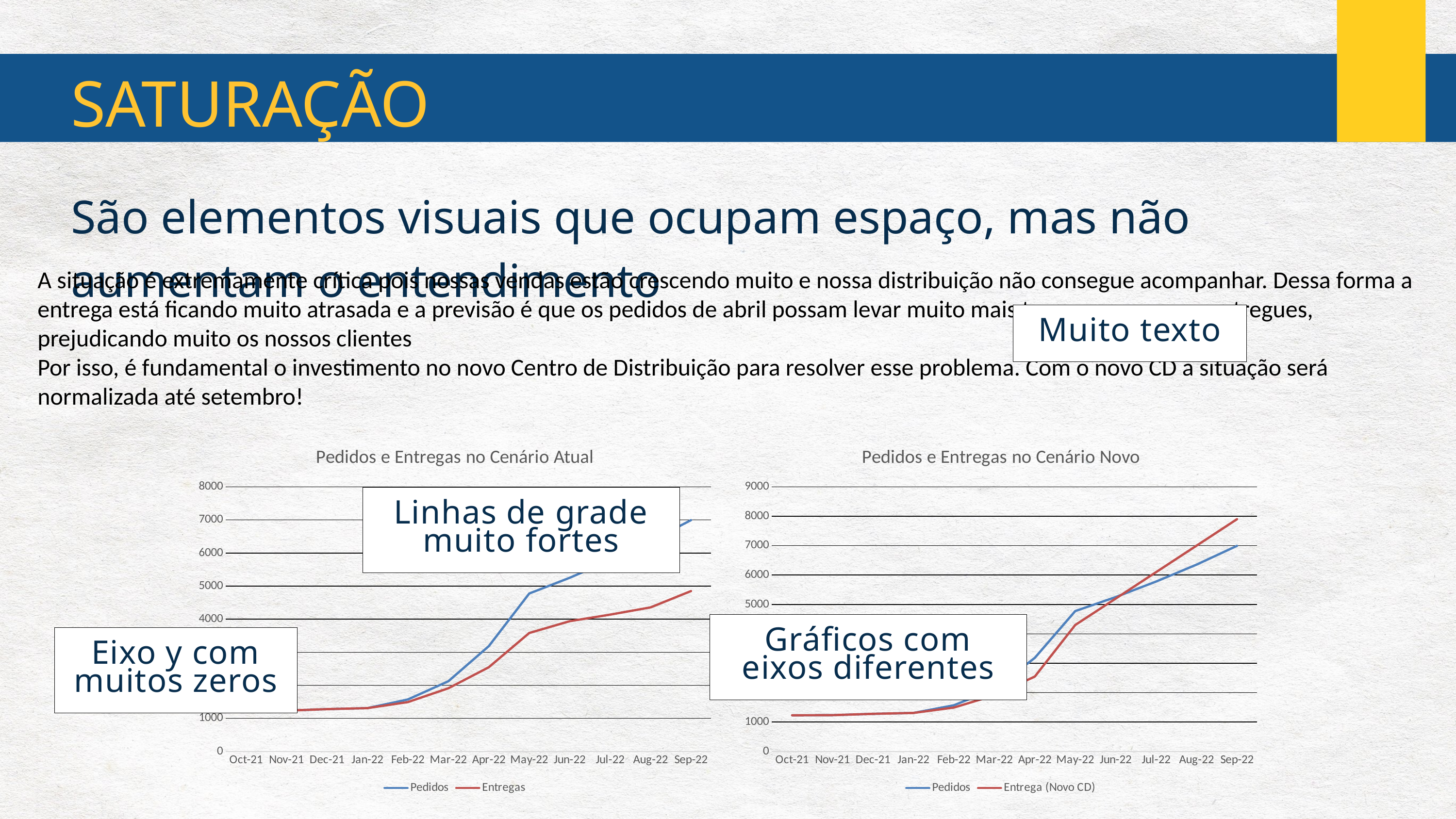
In 'Pedidos e Entregas no Cenário Atual', in which month is the Pedidos value highest? Sep-22 In 'Pedidos e Entregas no Cenário Novo', which series has the larger value in Sep-22, Pedidos or Entrega (Novo CD)? Entrega (Novo CD) What is the title of the chart on the right of the slide? Pedidos e Entregas no Cenário Novo In 'Pedidos e Entregas no Cenário Novo', is the value for Entrega (Novo CD) in Sep-22 greater or less than 7000? greater In 'Pedidos e Entregas no Cenário Atual', is the value for Pedidos in May-22 greater or less than 4000? greater In 'Pedidos e Entregas no Cenário Atual', which series has the larger value in Sep-22, Pedidos or Entregas? Pedidos In 'Pedidos e Entregas no Cenário Novo', is the value for Entrega (Novo CD) in Oct-21 greater or less than 2000? less How many months are shown on the x axis of 'Pedidos e Entregas no Cenário Atual'? 12 How many series does the legend of 'Pedidos e Entregas no Cenário Novo' list? 2 What kind of chart is 'Pedidos e Entregas no Cenário Atual'? line chart In 'Pedidos e Entregas no Cenário Atual', do the Pedidos values rise or fall from Oct-21 to Sep-22? rise